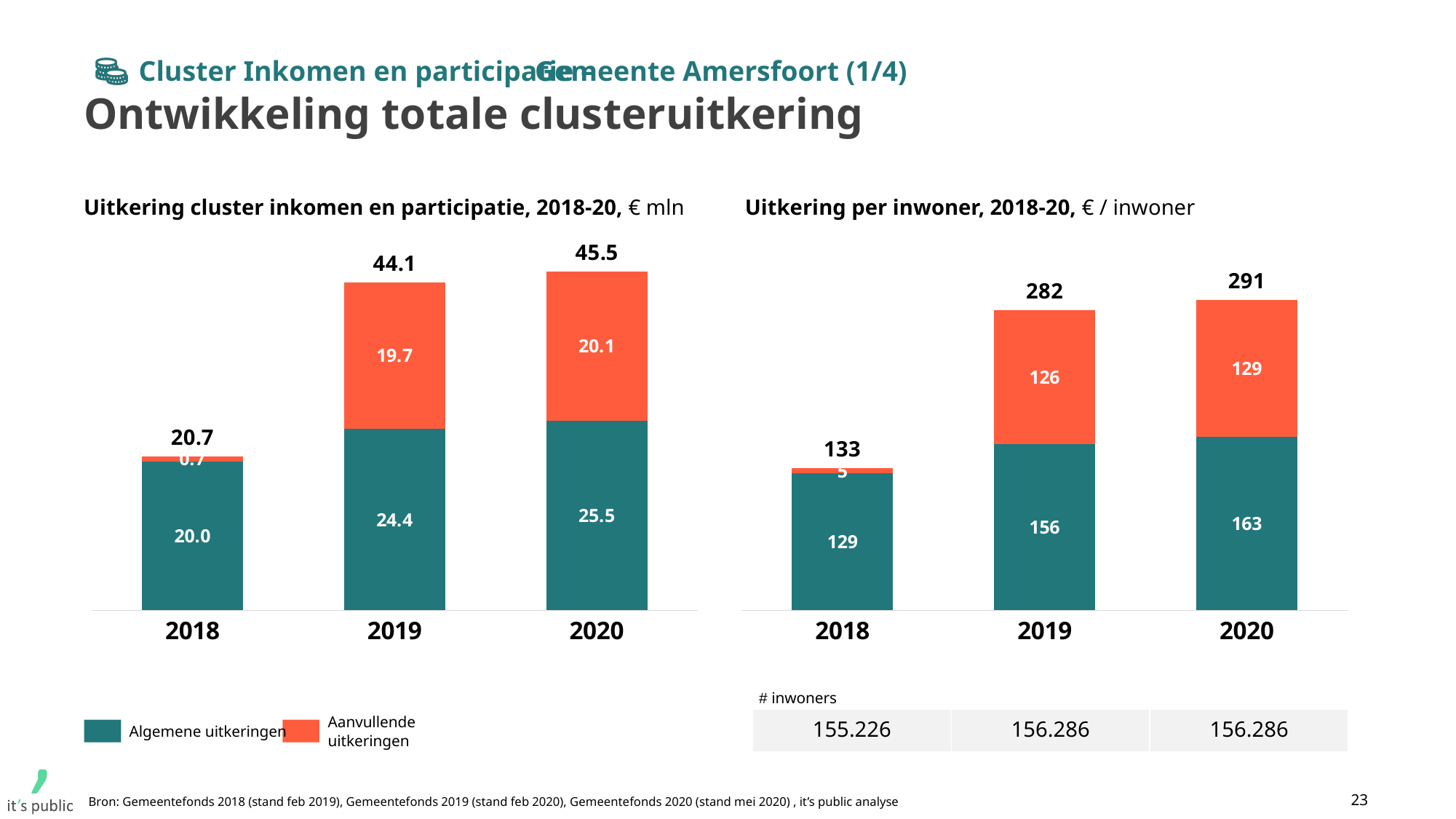
In the chart 'Uitkering cluster inkomen en participatie, 2018-20', which year has the highest total? 2020 In the chart 'Uitkering per inwoner, 2018-20', which year has the lowest total? 2018 In the chart 'Uitkering per inwoner, 2018-20', is the total for 2019 or 2020 larger? 2020 In the chart 'Uitkering per inwoner, 2018-20', what is the value of Algemene uitkeringen for 2020? 163 How many years are shown on the x axis of the chart 'Uitkering cluster inkomen en participatie, 2018-20'? 3 In the chart 'Uitkering cluster inkomen en participatie, 2018-20', what is the value of Algemene uitkeringen for 2019? 24.4 In the chart 'Uitkering cluster inkomen en participatie, 2018-20', what is the total of the stacked bar for 2018? 20.7 In the chart 'Uitkering cluster inkomen en participatie, 2018-20', what is the value of Aanvullende uitkeringen for 2020? 20.1 In the chart 'Uitkering per inwoner, 2018-20', what is the total of the stacked bar for 2020? 291 In the chart 'Uitkering cluster inkomen en participatie, 2018-20', what is the difference between the totals for 2019 and 2018? 23.4 How many series does the legend list for the chart 'Uitkering cluster inkomen en participatie, 2018-20'? 2 In the chart 'Uitkering per inwoner, 2018-20', what is the value of Aanvullende uitkeringen for 2019? 126